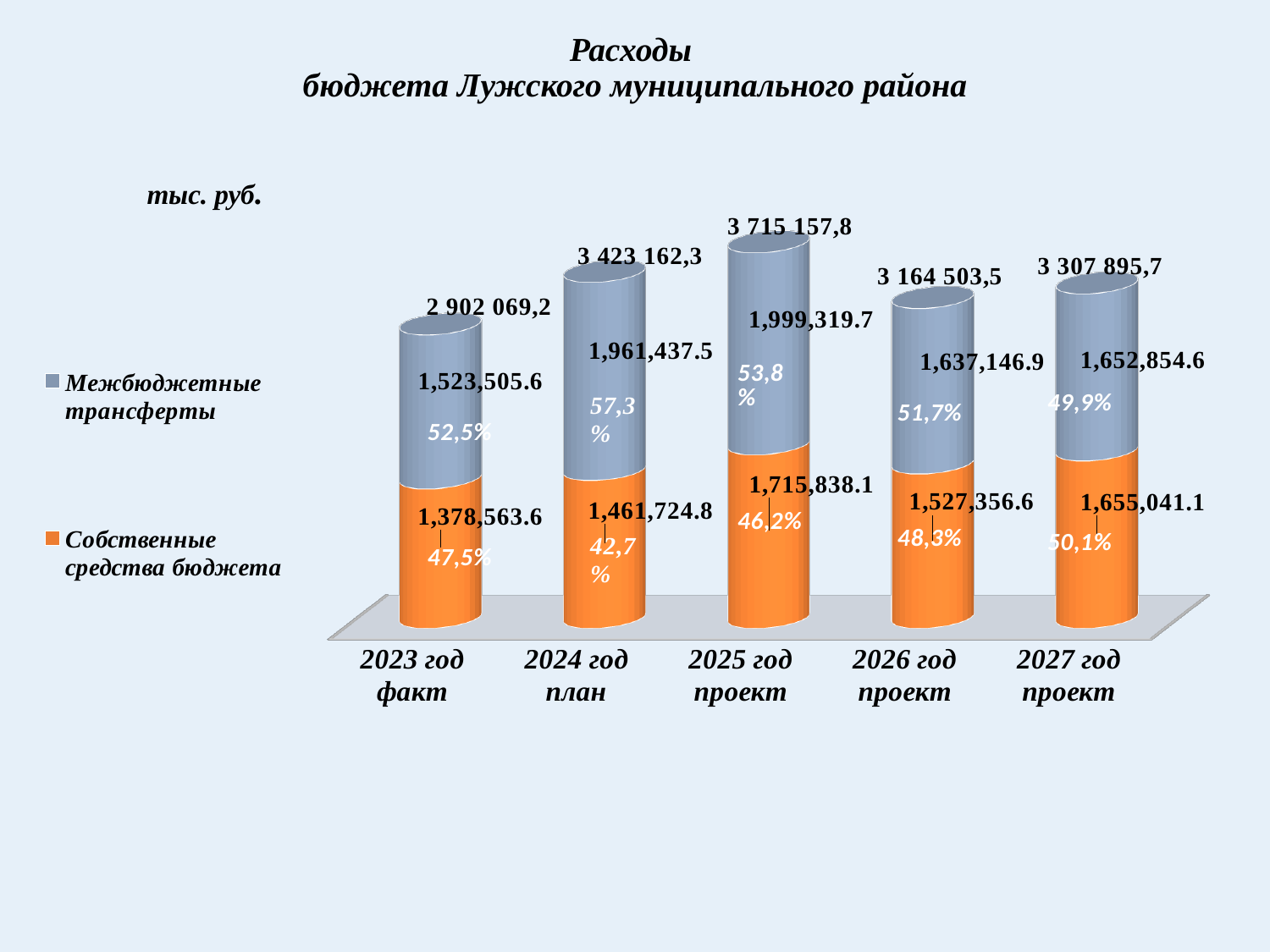
In 2026 год проект, which is larger: Межбюджетные трансферты or Собственные средства бюджета? Межбюджетные трансферты What is the total expenditure shown above the bar for 2024 год план? 3 423 162,3 Which category has the lowest total expenditure? 2023 год факт What is the difference between the total for 2025 год проект and the total for 2024 год план? 291 995,5 What kind of chart is shown on the slide? Stacked bar chart Which category has the highest total expenditure? 2025 год проект What is the value of Собственные средства бюджета for 2023 год факт? 1,378,563.6 How many series does the legend list? 2 How many categories (years) are shown on the x axis? 5 What is the value of Межбюджетные трансферты for 2025 год проект? 1,999,319.7 What percentage share is printed for Межбюджетные трансферты in 2023 год факт? 52,5% In what units are the values on the chart expressed? тыс. руб.